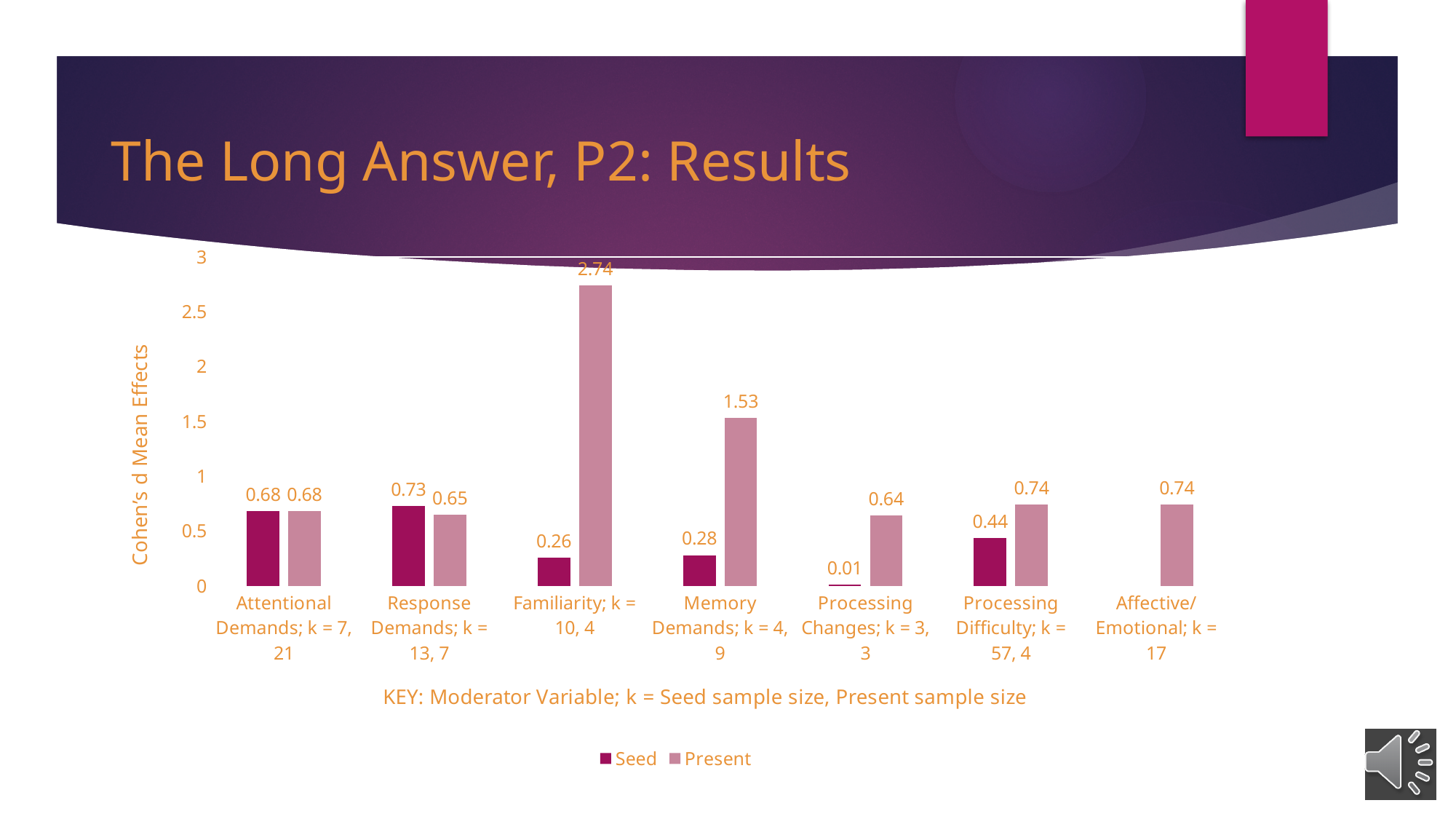
What is the label of the y axis? Cohen's d Mean Effects How many series does the legend list? 2 Which category has the highest Present value? Familiarity Which category has the lowest Seed value? Processing Changes What is the Present value for Familiarity? 2.74 What is the Seed value for Response Demands? 0.73 What kind of chart is shown on the slide? Bar chart How many categories are shown on the x axis? 7 What is the Seed value for Processing Changes? 0.01 What is the difference between the Present and Seed values for Familiarity? 2.48 Which is larger for Response Demands, the Seed value or the Present value? Seed What is the Present value for Memory Demands? 1.53